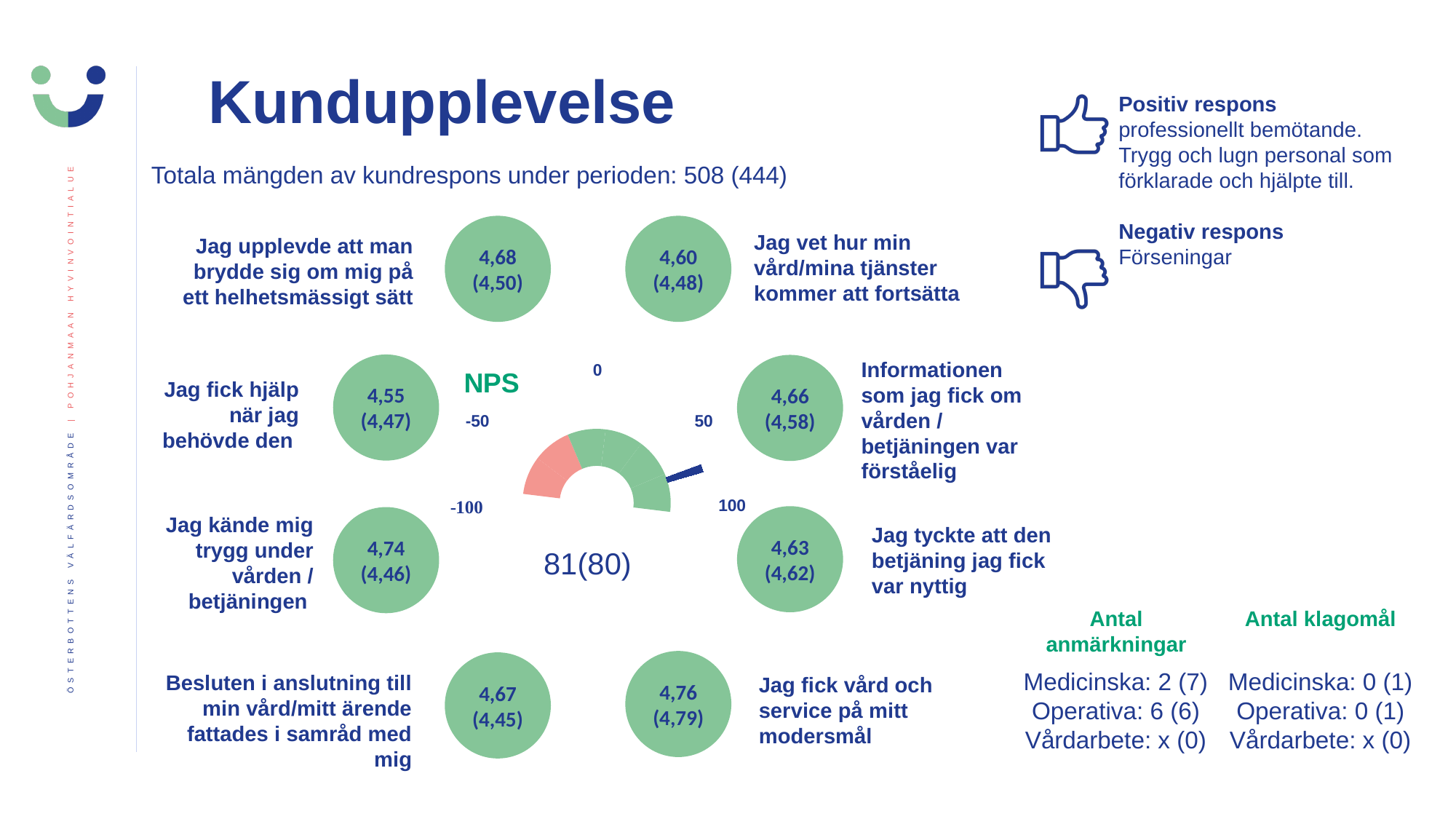
What NPS value is printed below the gauge chart? 81(80) Which statement has the highest current value among the green circles? Jag fick vård och service på mitt modersmål What kind of chart is the NPS chart in the centre of the slide? gauge chart What value is shown in the green circle for 'Jag fick hjälp när jag behövde den'? 4,55 (4,47) What value is shown in the green circle for 'Jag fick vård och service på mitt modersmål'? 4,76 (4,79) How many green circles with scores are shown on the slide? 8 What is the difference between the current value for 'Jag kände mig trygg under vården / betjäningen' (4,74) and 'Jag fick hjälp när jag behövde den' (4,55)? 0,19 On the NPS gauge, is the needle pointing to a value greater or less than 0? greater What is the lowest tick value shown on the NPS gauge scale? -100 On the NPS gauge, is the needle pointing to a value greater or less than 50? greater Which statement has the lowest current value among the green circles? Jag fick hjälp när jag behövde den What is the highest tick value shown on the NPS gauge scale? 100